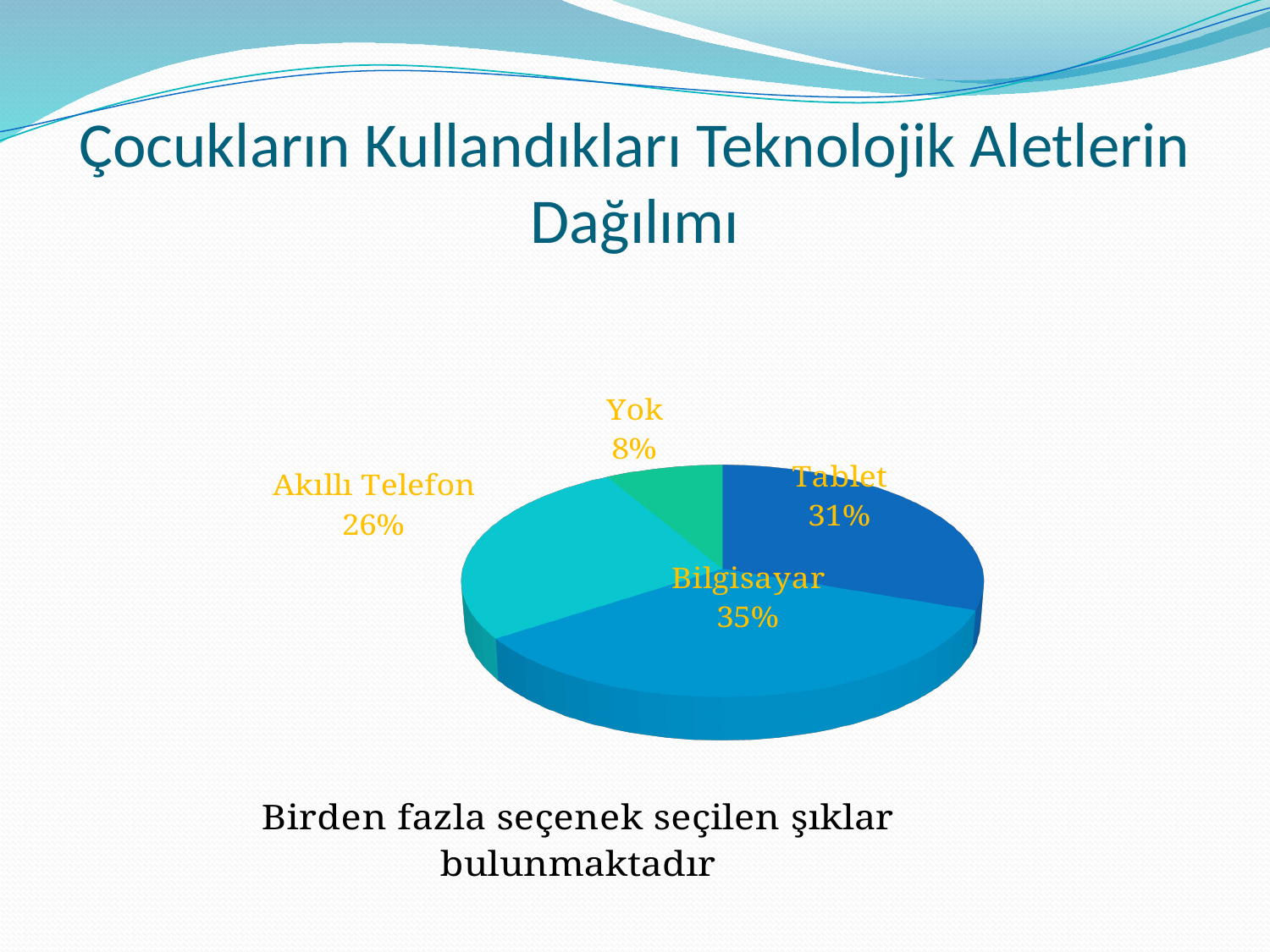
What percentage of the pie is labelled Tablet? 31% Which slice of the pie is the largest? Bilgisayar Which slice of the pie is the smallest? Yok What kind of chart is shown on the slide? pie chart What percentage of the pie is labelled Akıllı Telefon? 26% What percentage of the pie is labelled Bilgisayar? 35% Which is larger, the Tablet slice or the Akıllı Telefon slice? Tablet What percentage of the pie is labelled Yok? 8% What is the difference in percentage points between Bilgisayar and Akıllı Telefon? 9 What is the difference in percentage points between Tablet and Yok? 23 How many slices does the pie chart have? 4 What is the title of the slide containing the pie chart? Çocukların Kullandıkları Teknolojik Aletlerin Dağılımı